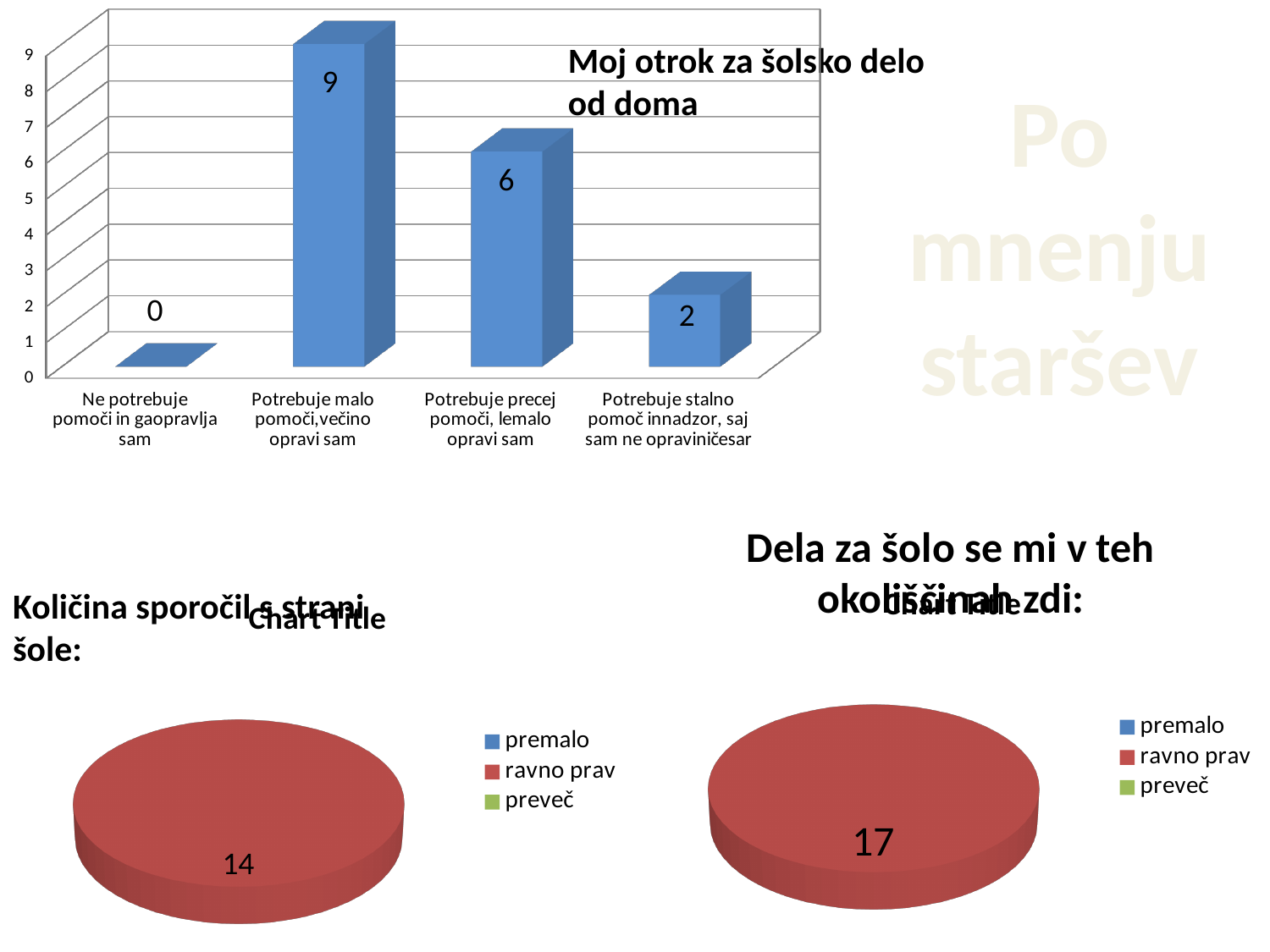
How many entries does the legend of the bottom-right pie chart list? 3 In the top bar chart, what is the value for 'Potrebuje stalno pomoč in nadzor, saj sam ne opravi ničesar'? 2 How many categories does the top bar chart show? 4 In the bottom-left pie chart, what value is shown on the 'ravno prav' slice? 14 In the top bar chart, which category has the lowest value? Ne potrebuje pomoči in ga opravlja sam What kind of chart is the top chart on the slide? Bar chart In the top bar chart, which category has the highest value? Potrebuje malo pomoči, večino opravi sam In the top bar chart, which is larger: the value for 'Potrebuje precej pomoči' or 'Potrebuje stalno pomoč'? Potrebuje precej pomoči In the top bar chart, what is the value for 'Potrebuje malo pomoči, večino opravi sam'? 9 In the bottom-right pie chart, what value is shown on the 'ravno prav' slice? 17 In the top bar chart, what is the difference between the values for 'Potrebuje malo pomoči' and 'Potrebuje precej pomoči'? 3 In the top bar chart, what is the value for 'Potrebuje precej pomoči, le malo opravi sam'? 6